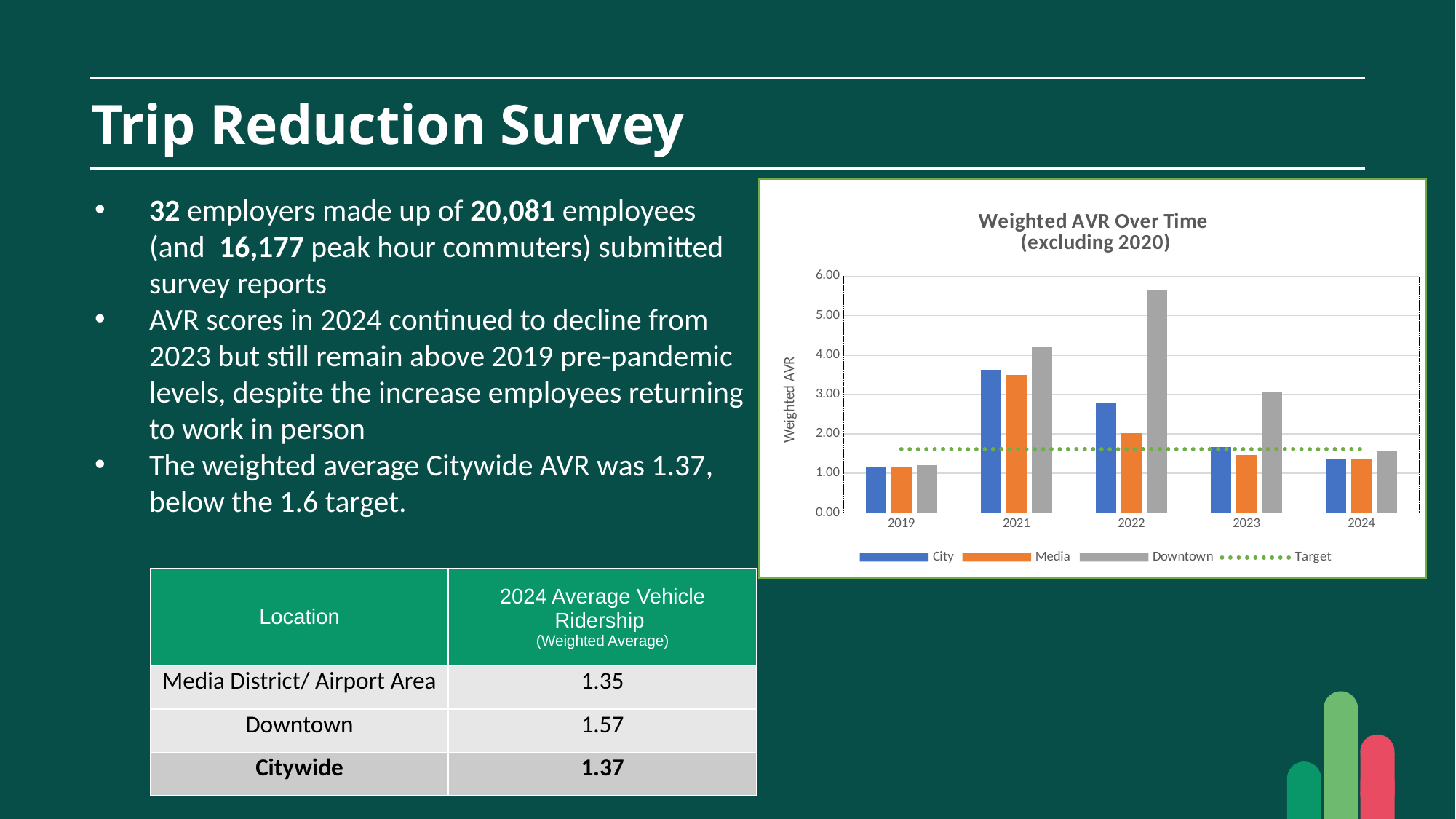
Is the Downtown value for 2022 greater or less than 5.00? greater What kind of chart is shown on the slide? combination bar and line chart Is the Media value for 2022 greater or less than 3.00? less How many entries does the legend of the Weighted AVR Over Time chart list? 4 What is the label on the y axis of the chart? Weighted AVR In which year is the Downtown bar highest? 2022 Which series has the highest bar in 2022? Downtown Does the Downtown value rise or fall from 2022 to 2024? fall How many years are shown on the x axis of the Weighted AVR Over Time chart? 5 In 2022, which is larger, the City value or the Media value? City Is the Downtown value for 2023 greater or less than 2.00? greater In which year is the Downtown bar lowest? 2019